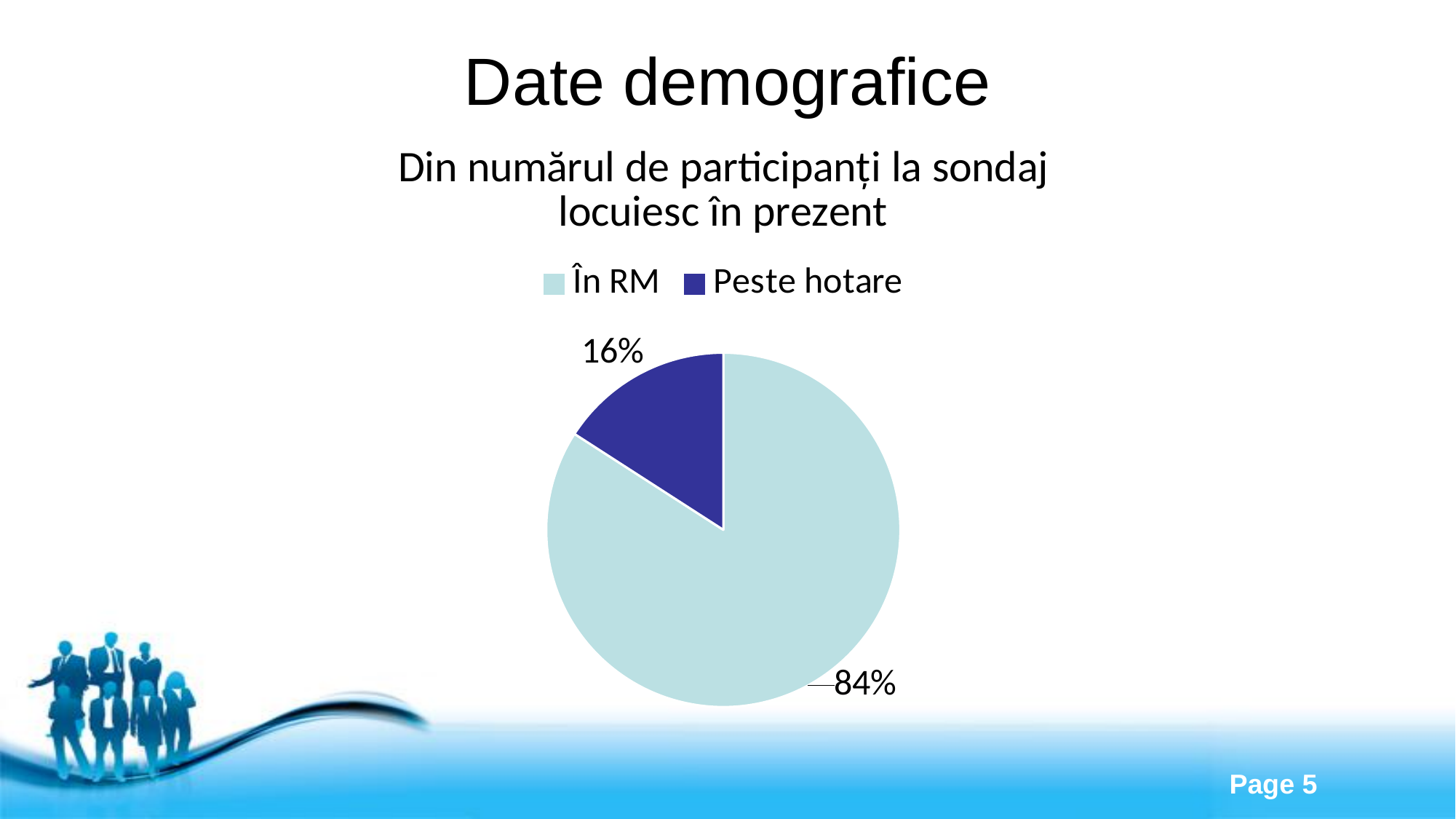
What share of participants live in RM (În RM)? 84% What is the title of the chart? Din numărul de participanți la sondaj locuiesc în prezent Which category has the smallest share of the pie? Peste hotare How many entries does the legend list? 2 How many slices does the pie chart have? 2 What share of participants live abroad (Peste hotare)? 16% Which colour represents Peste hotare in the pie chart? dark blue Which category has the largest share of the pie? În RM What kind of chart is shown on the slide? pie chart What is the difference in percentage points between În RM and Peste hotare? 68 Which is larger, the share for În RM or the share for Peste hotare? În RM